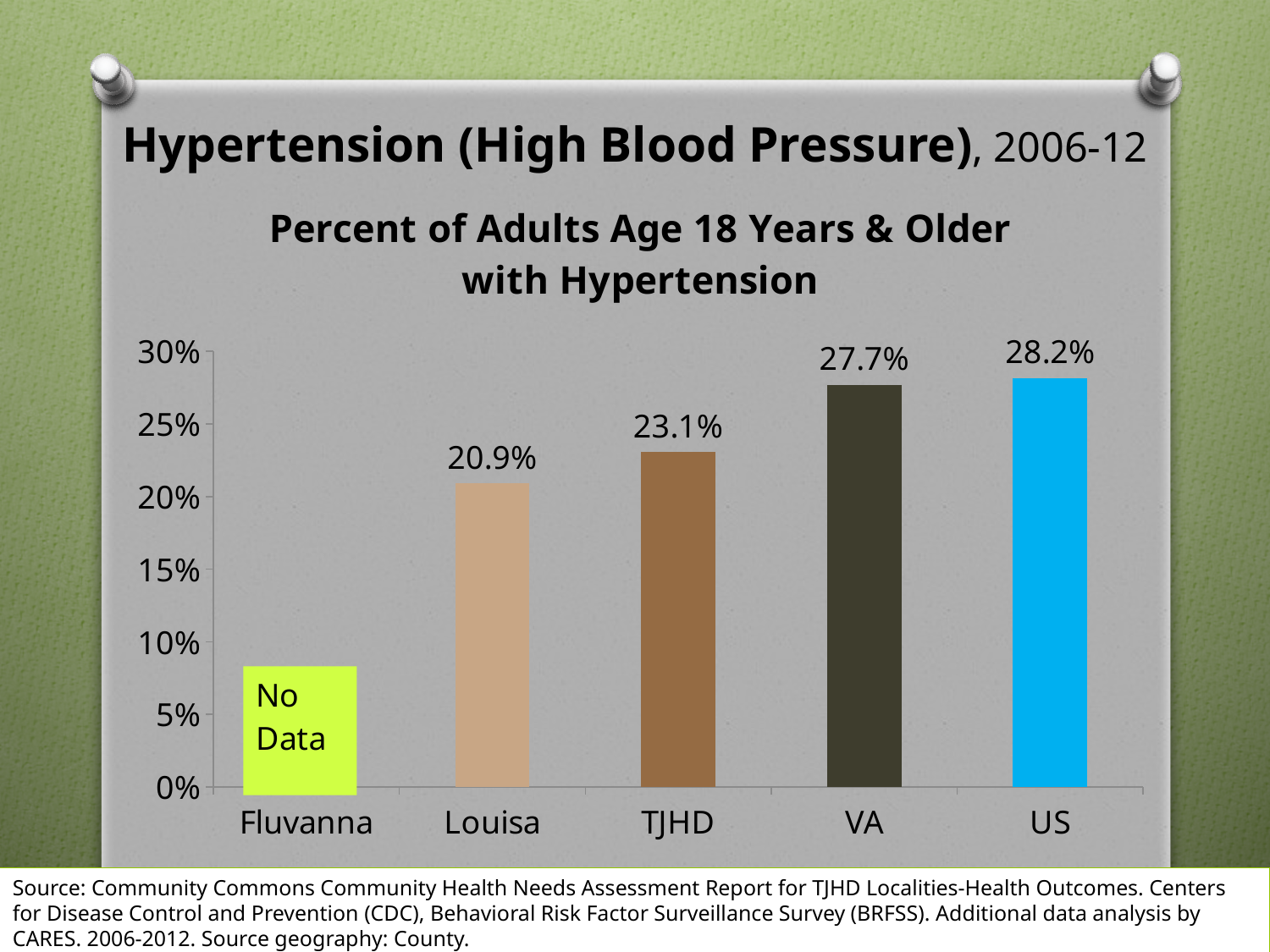
What is shown for Fluvanna on the chart? No Data What is the value for US? 28.2% Which is larger, the value for TJHD or the value for Louisa? TJHD What kind of chart is shown? Bar chart What is the value for Louisa? 20.9% Which category has the highest value? US What is the difference between the VA value and the TJHD value? 4.6% What is the value for VA? 27.7% How many categories are shown on the x axis? 5 Among the categories with data, which has the lowest value? Louisa What is the difference between the US value and the Louisa value? 7.3% What is the value for TJHD? 23.1%